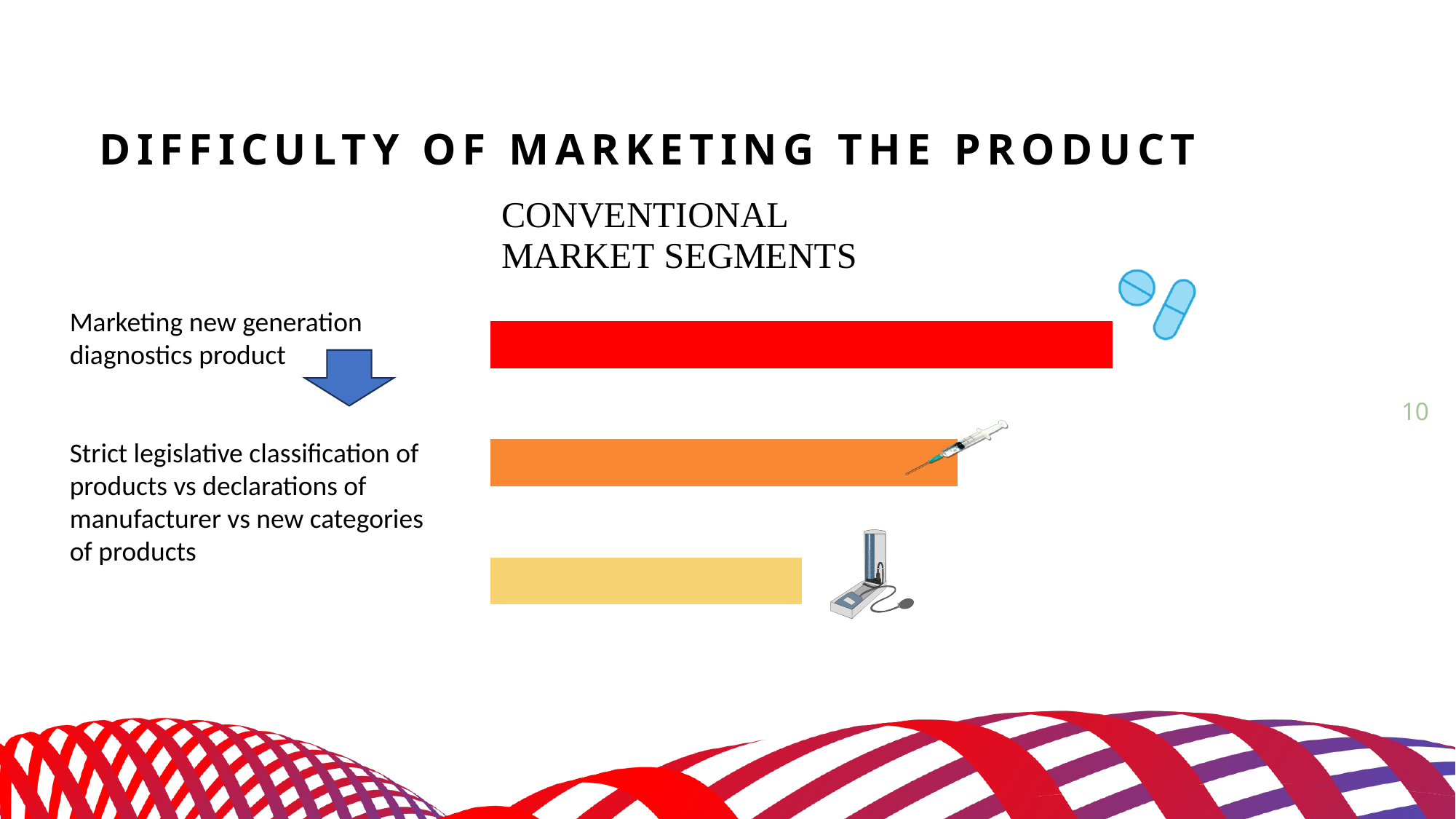
What kind of chart is shown under the heading CONVENTIONAL MARKET SEGMENTS? bar chart How many bars does the CONVENTIONAL MARKET SEGMENTS chart contain? 3 What colour is the top bar in the CONVENTIONAL MARKET SEGMENTS chart? red Do the bar lengths in the CONVENTIONAL MARKET SEGMENTS chart increase or decrease from the top bar to the bottom bar? decrease In the CONVENTIONAL MARKET SEGMENTS chart, is the orange bar longer or shorter than the yellow bar? longer Which bar in the CONVENTIONAL MARKET SEGMENTS chart is the shortest? the yellow (bottom) bar In the CONVENTIONAL MARKET SEGMENTS chart, is the orange bar longer or shorter than the red bar? shorter Which bar in the CONVENTIONAL MARKET SEGMENTS chart is the longest? the red (top) bar What is the title of the chart on the slide? CONVENTIONAL MARKET SEGMENTS